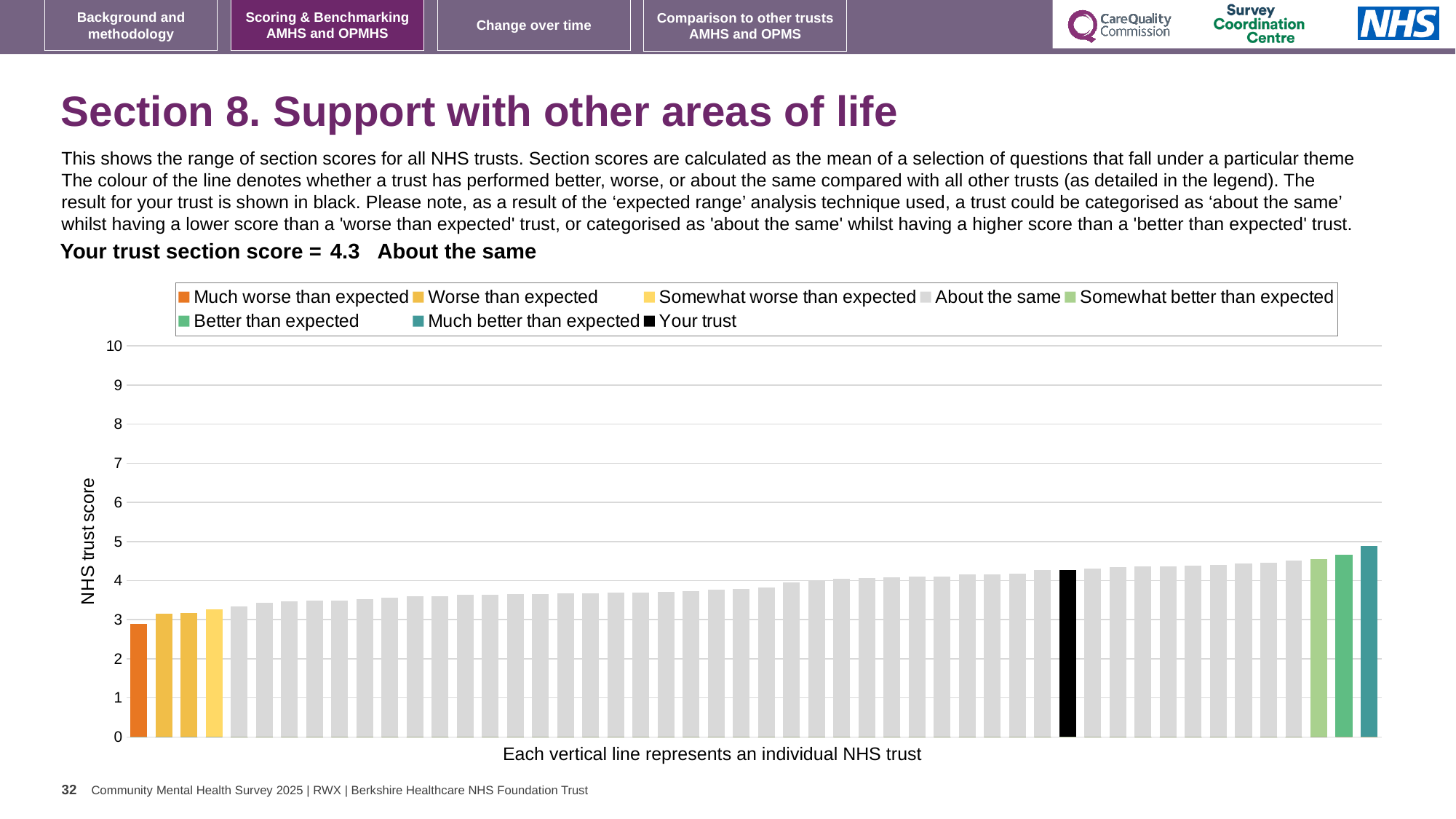
Do the bar values rise or fall from left to right along the x axis? rise Is the value for your trust greater or less than 5? less Which legend category does the shortest bar belong to? Much worse than expected Which is larger, the value for your trust or the value of the tallest bar? the tallest bar Is the value for your trust greater or less than 4? greater What is the label on the y axis of the chart? NHS trust score How many entries does the chart legend list? 8 Which legend category does the tallest bar belong to? Much better than expected How many bars are coloured as 'Worse than expected'? 2 What kind of chart is shown on the slide? bar chart What is the section score for your trust? 4.3 Is the value of the tallest bar greater or less than 4? greater